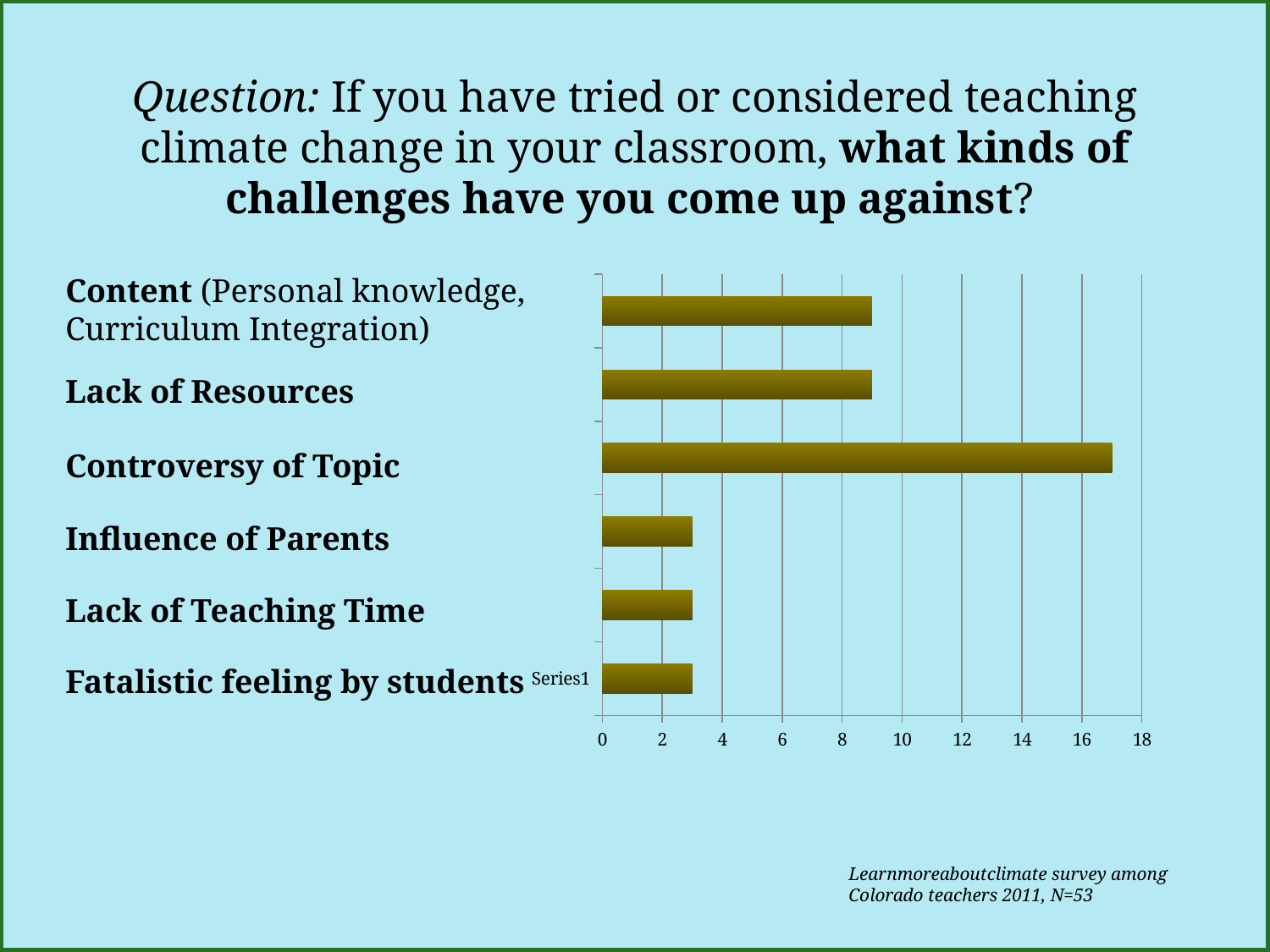
What is the highest value shown on the chart's horizontal axis? 18 Is the value for Controversy of Topic greater or less than 16? greater Which is larger, the value for Controversy of Topic or the value for Fatalistic feeling by students? Controversy of Topic Is the value for Controversy of Topic greater or less than 18? less How many bars (challenge categories) does the chart show? 6 Is the value for Content (Personal knowledge, Curriculum Integration) greater or less than 10? less What kind of chart is shown on the slide? bar chart Which challenge has the highest value in the chart? Controversy of Topic